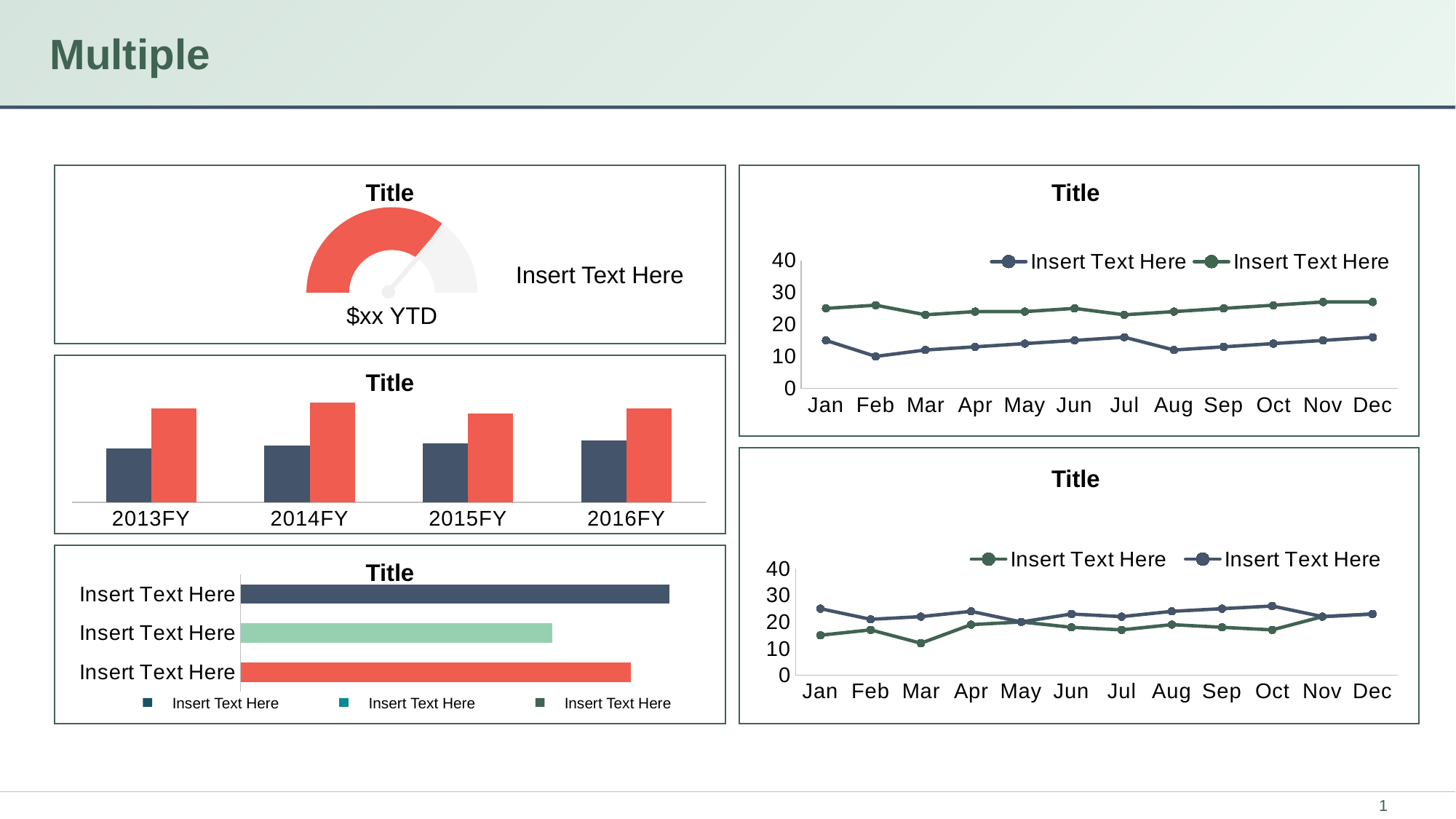
In the bottom-left horizontal bar chart, which colour bar is the longest? dark blue What kind of chart is the bottom-left chart with three horizontal bars? bar chart In the top-right line chart, is the value of the dark blue line for Feb greater or less than 20? less What text is shown below the gauge in the top-left chart? $xx YTD How many fiscal-year categories does the middle-left bar chart show? 4 In the bottom-right line chart, is the value of the green line for Mar greater or less than 20? less In the middle-left bar chart, for 2014FY, which bar is taller, the dark blue one or the red one? the red one In the top-right line chart, is the value of the green line for Dec greater or less than 20? greater What kind of chart is the middle chart on the left side of the slide, with categories 2013FY to 2016FY? bar chart How many series does the legend of the top-right line chart list? 2 How many months are plotted along the x axis of the top-right line chart? 12 What kind of chart is the top-right chart with months Jan to Dec on the x axis? line chart